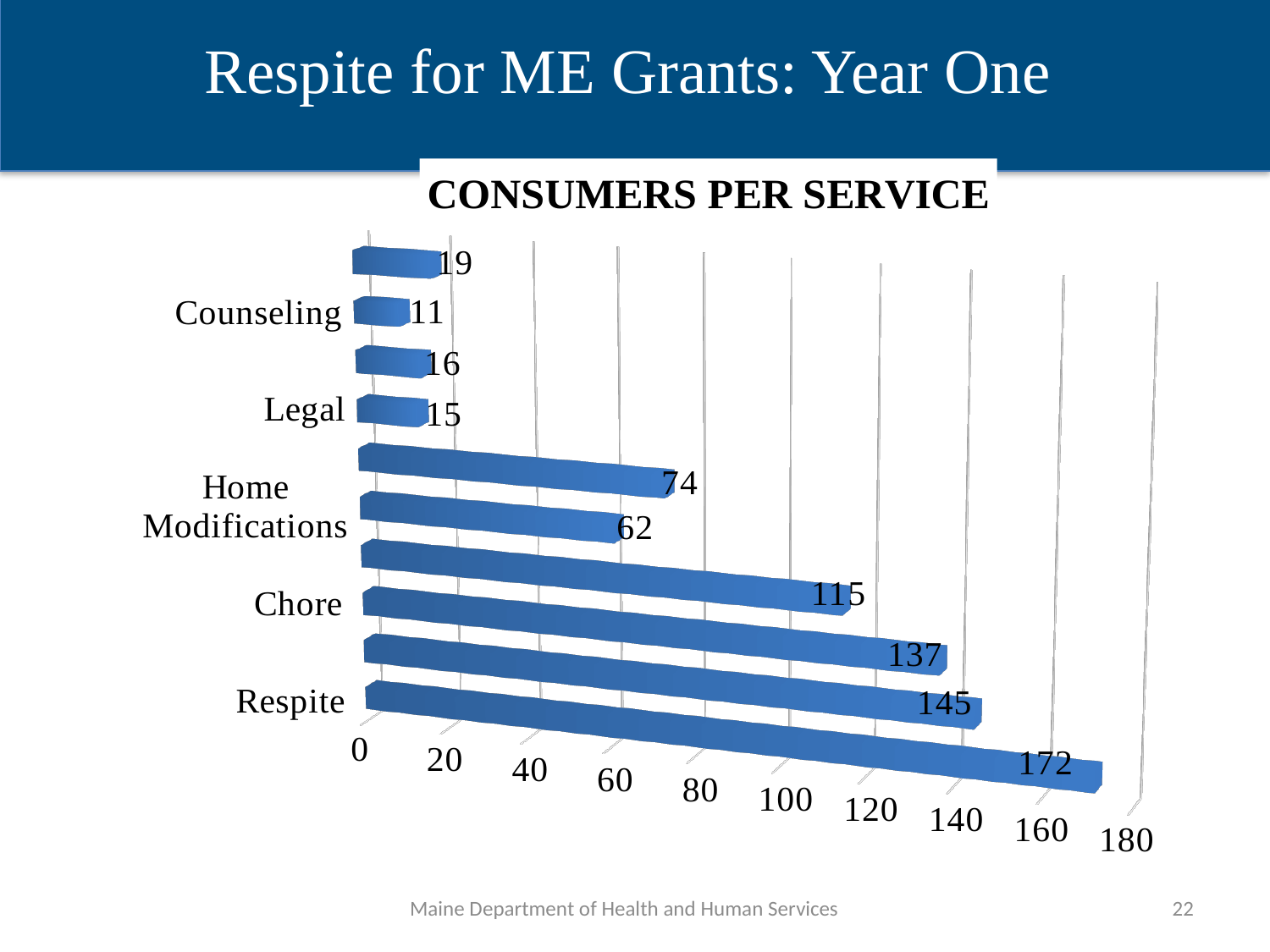
Is the value for Respite greater or less than 160? greater What is the highest value shown in the chart? 172 What is the value for Counseling? 11 What is the difference between the two largest values, 172 and 145? 27 What kind of chart is shown on the slide? bar chart What is the maximum value shown on the horizontal axis? 180 What is the title of the chart? CONSUMERS PER SERVICE What is the value for Respite? 172 What is the lowest value shown in the chart? 11 What is the value for Legal? 15 Which is larger, the bar labelled 74 or the bar labelled 62? 74 How many bars are plotted in the chart? 10